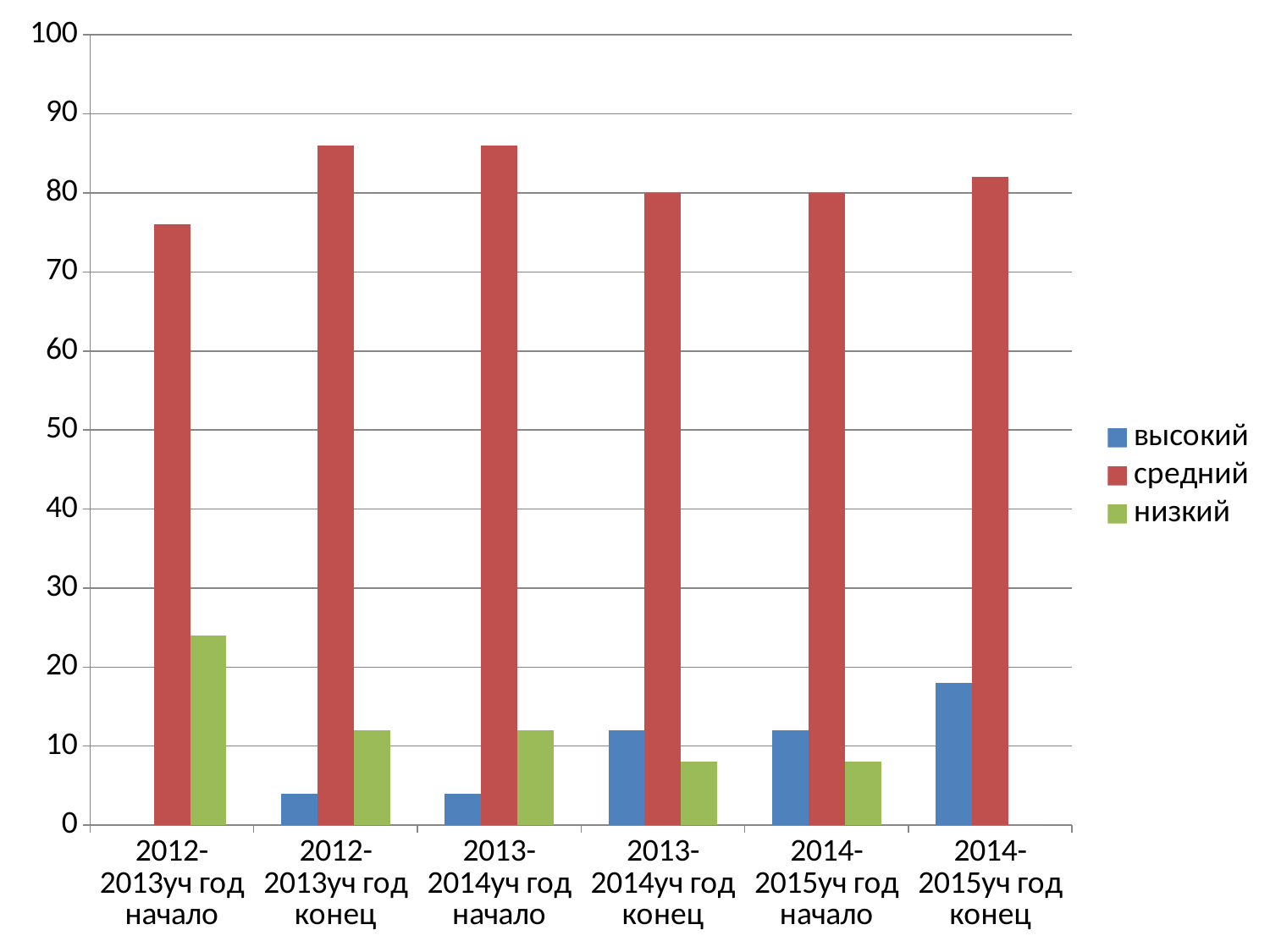
Is the value of низкий for 2012-2013уч год начало greater or less than 20? greater What is the value of средний for 2013-2014уч год конец? 80 Is the value of высокий for 2014-2015уч год конец greater or less than 20? less For 2013-2014уч год конец, which is larger: высокий or низкий? высокий How many categories are shown on the x axis? 6 In which category is the низкий value highest? 2012-2013уч год начало In which category is the высокий value highest? 2014-2015уч год конец Which colour represents the средний series in the legend? red How many series does the legend list? 3 In which category is the средний value lowest? 2012-2013уч год начало What is the value of средний for 2014-2015уч год начало? 80 What kind of chart is shown on the slide? bar chart